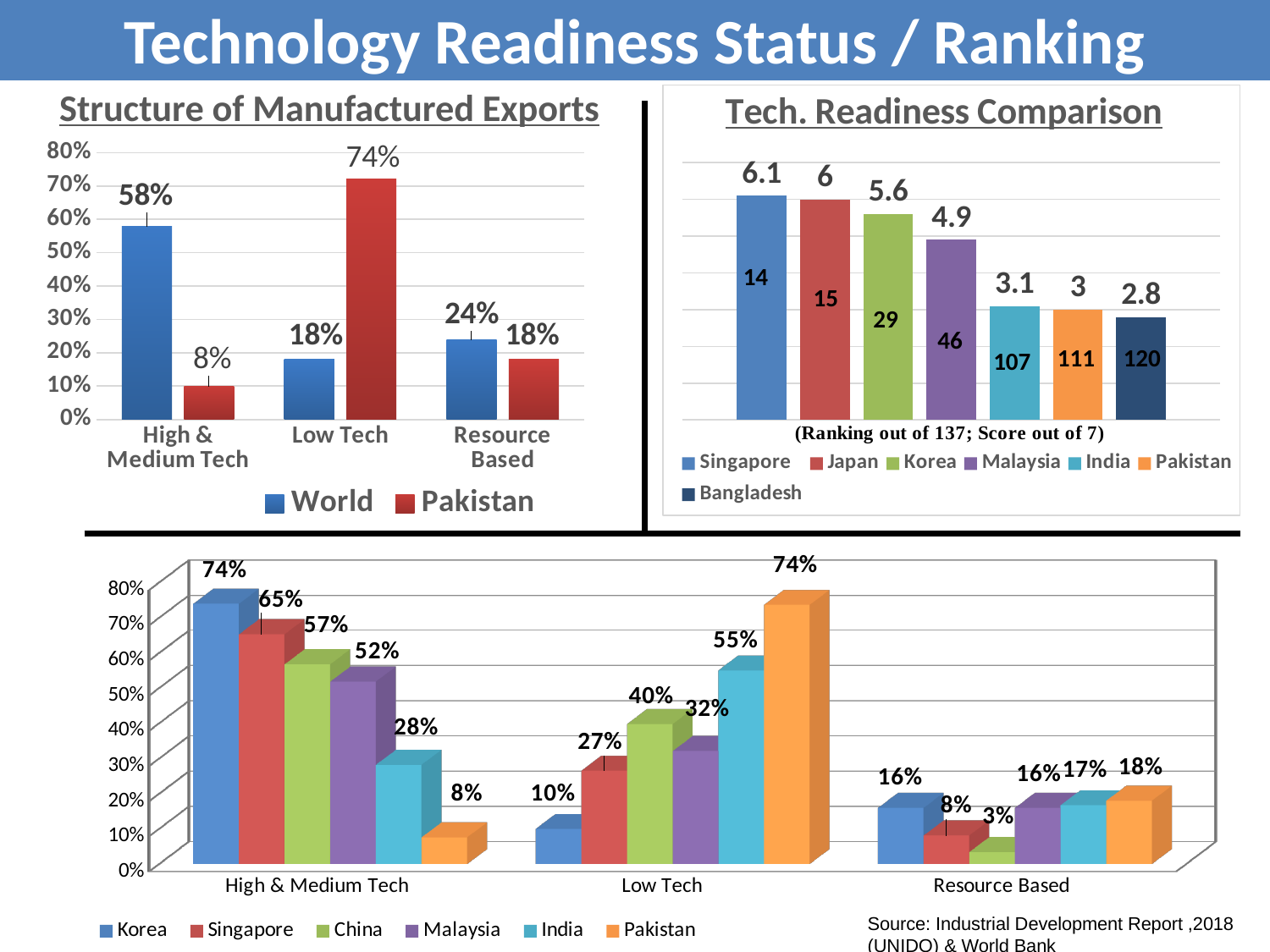
In the bottom chart, which is larger for High & Medium Tech: Korea or India? Korea In the bottom chart, what is the value for China in Low Tech? 40% In the 'Tech. Readiness Comparison' chart, how many countries does the legend list? 7 In the 'Structure of Manufactured Exports' chart, what is the difference between the World and Pakistan values for High & Medium Tech? 50% In the 'Tech. Readiness Comparison' chart, what is the score for Korea? 5.6 In the 'Tech. Readiness Comparison' chart, which country has the highest score? Singapore In the bottom chart, which country has the lowest value for Resource Based? China In the 'Structure of Manufactured Exports' chart, what is Pakistan's value for Low Tech? 74% In the 'Structure of Manufactured Exports' chart, what is the World value for High & Medium Tech? 58% In the 'Tech. Readiness Comparison' chart, what is the ranking shown for Pakistan? 111 In the 'Tech. Readiness Comparison' chart, which country has the lowest score? Bangladesh In the 'Structure of Manufactured Exports' chart, how many series does the legend list? 2